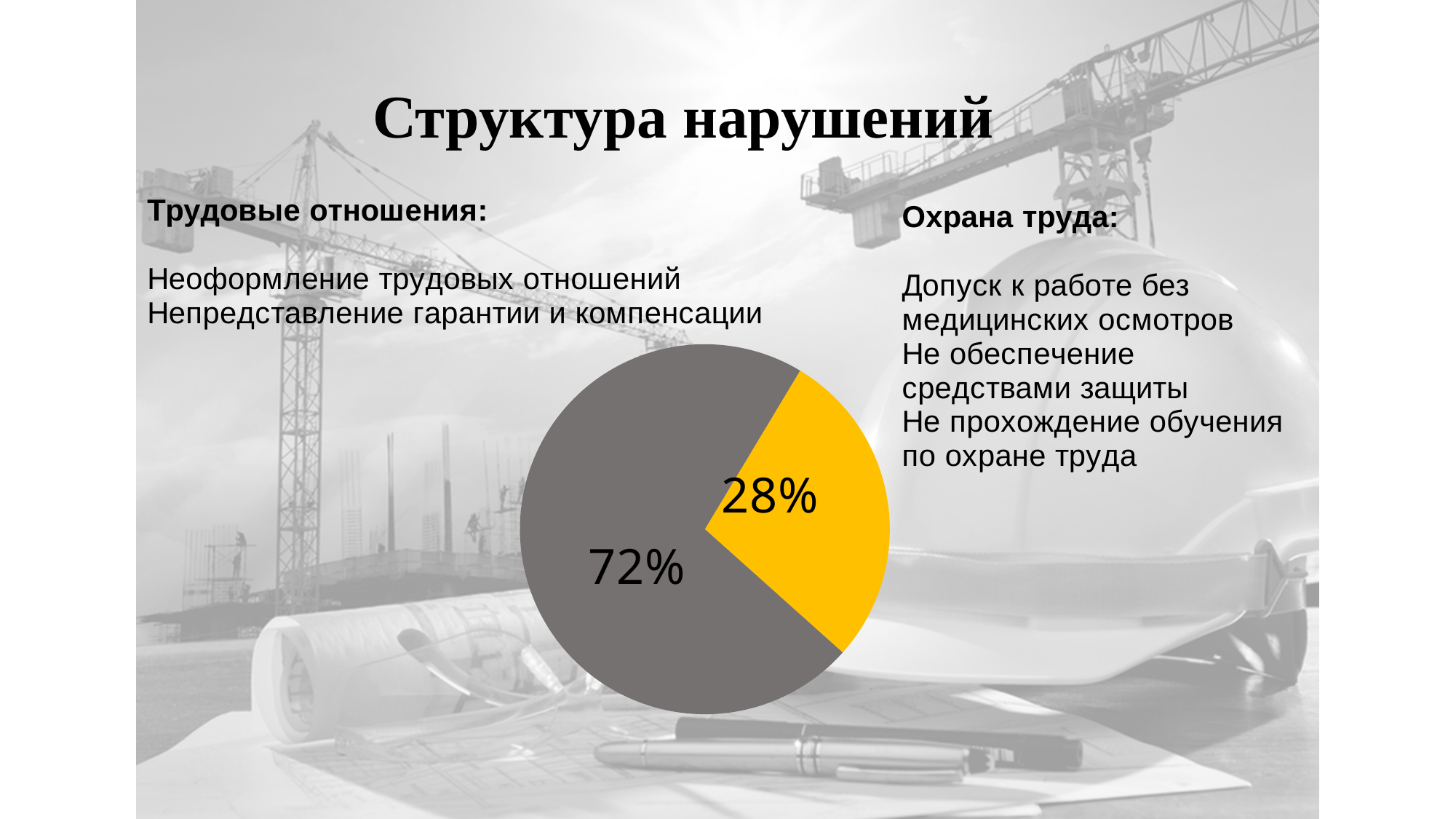
Is the gray slice of the pie chart larger or smaller than the yellow slice? larger Which slice of the pie chart is the largest, the gray one or the yellow one? the gray one What percentage is shown on the yellow slice of the pie chart? 28% Which slice of the pie chart is the smallest, the gray one or the yellow one? the yellow one What percentage is shown on the gray slice of the pie chart? 72% What do the two slices of the pie chart add up to? 100% What is the difference in percentage points between the gray slice and the yellow slice of the pie chart? 44 What kind of chart is shown on the slide? pie chart Is the value of the yellow slice of the pie chart greater or less than 50%? less What is the title of the slide containing the pie chart? Структура нарушений How many slices does the pie chart have? 2 What colour is the slice labelled 28% in the pie chart? yellow